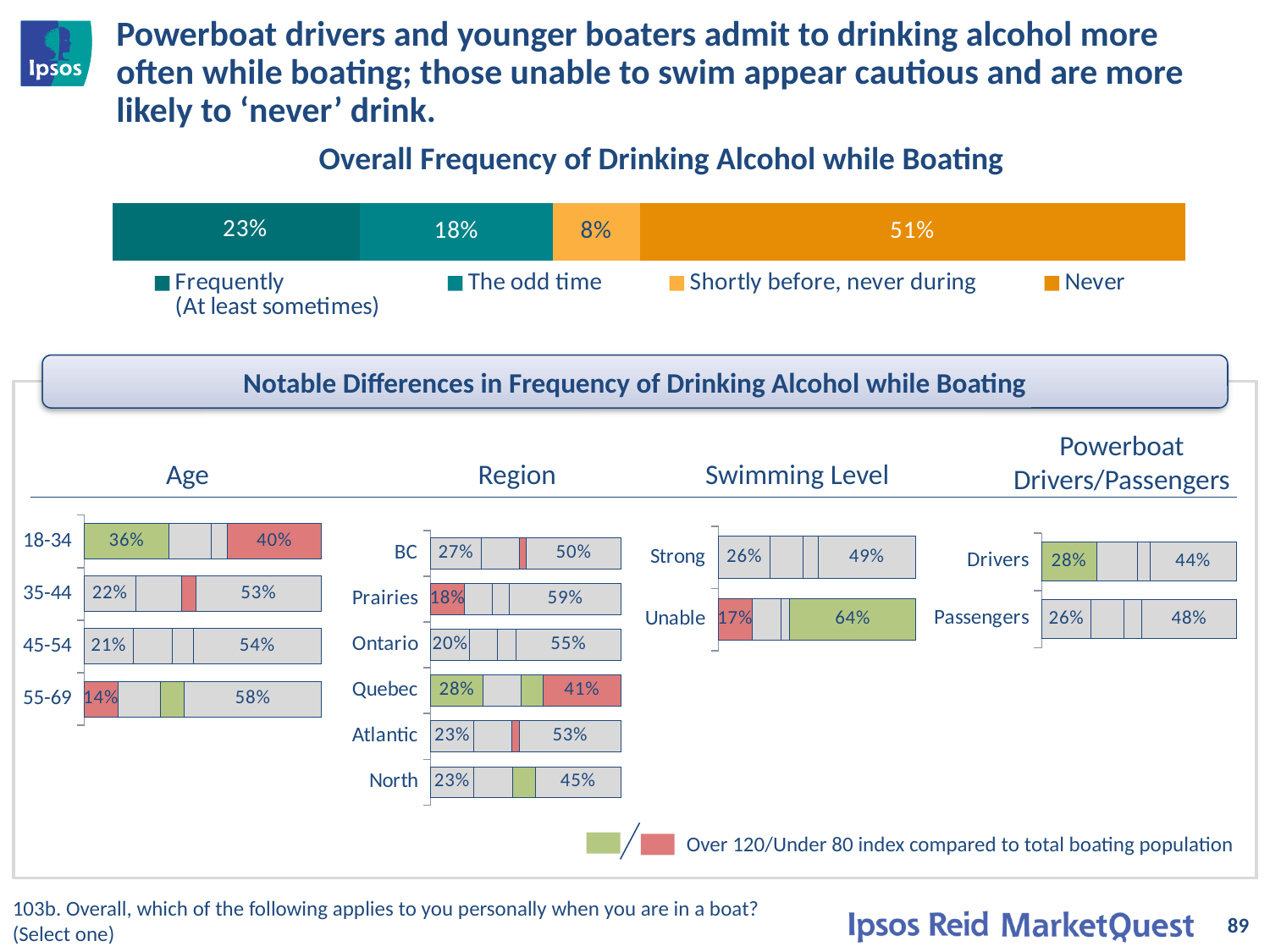
In the 'Overall Frequency of Drinking Alcohol while Boating' chart, what percentage of boaters say they 'Never' drink alcohol while boating? 51% In the Swimming Level chart, what percentage of boaters unable to swim say they never drink while boating? 64% In the 'Overall Frequency of Drinking Alcohol while Boating' chart, what is the difference between the 'Never' share and the 'Frequently' share? 28 percentage points In the 'Overall Frequency of Drinking Alcohol while Boating' chart, what percentage say 'Frequently (At least sometimes)'? 23% How many series does the legend of the 'Overall Frequency of Drinking Alcohol while Boating' chart list? 4 What kind of chart is the 'Overall Frequency of Drinking Alcohol while Boating' chart? Stacked bar chart In the Age chart, what percentage of 18-34 year olds drink alcohol frequently while boating? 36% In the 'Overall Frequency of Drinking Alcohol while Boating' chart, which response category has the smallest share? Shortly before, never during In the Region chart, how many regions are shown? 6 In the Region chart, which region has the lowest 'Never' percentage? Quebec In the Age chart, which age group has the highest 'Never' percentage? 55-69 In the Powerboat Drivers/Passengers chart, which group has the higher 'Frequently' percentage, Drivers or Passengers? Drivers